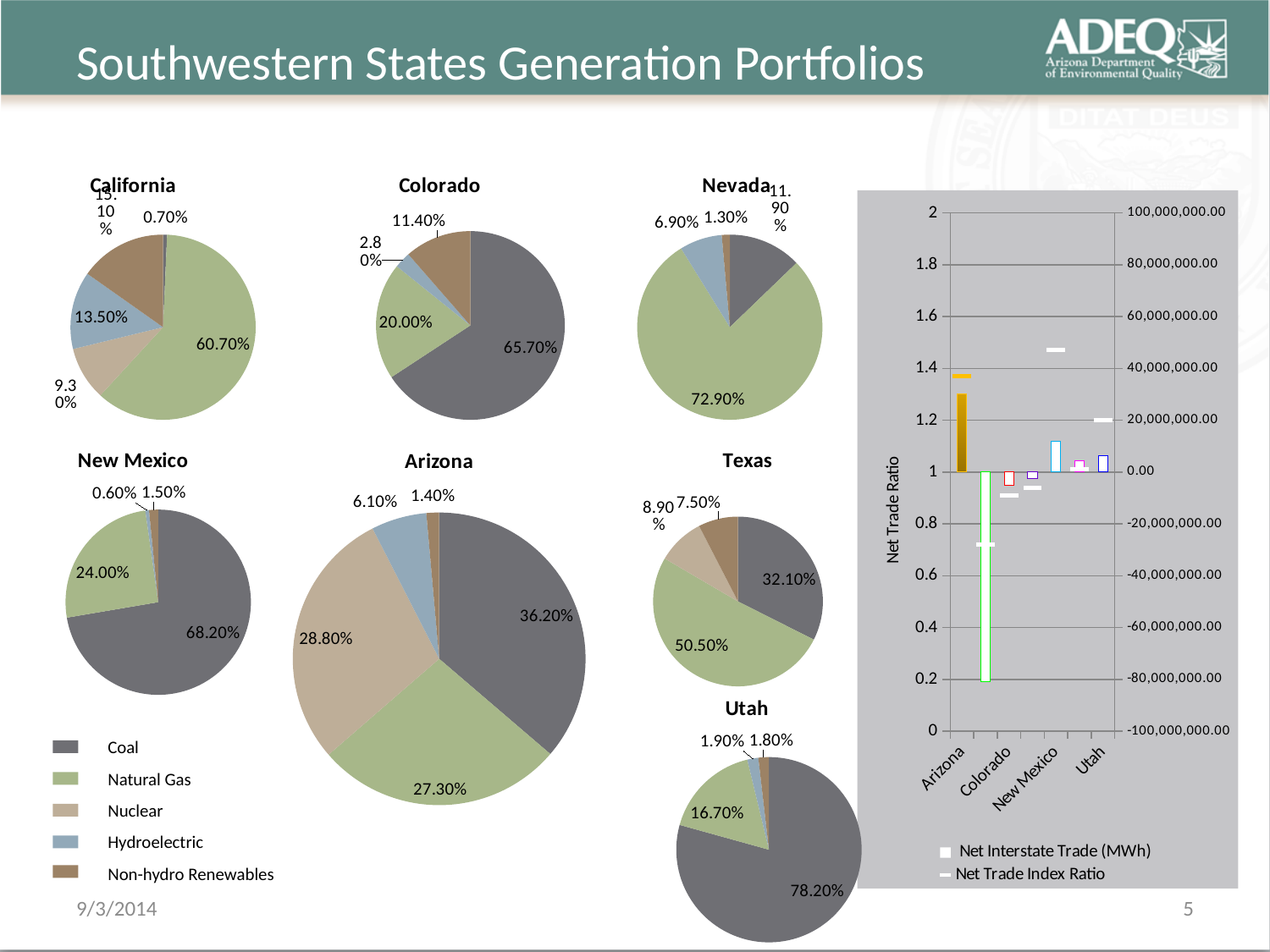
In the Colorado pie chart, what percentage is Coal? 65.70% In the New Mexico pie chart, which source has the smallest share? Hydroelectric In the Nevada pie chart, what is the Natural Gas share? 72.90% In the California pie chart, what share of generation comes from Natural Gas? 60.70% What kind of chart is the chart on the right of the slide showing Net Trade Ratio? Combination bar and line chart In the Arizona pie chart, what percentage is Nuclear? 28.80% How many slices does the Arizona pie chart have? 5 In the Texas pie chart, what is the difference between the Natural Gas share and the Coal share? 18.40% In the Arizona pie chart, which is larger, the Coal share or the Natural Gas share? Coal How many series does the legend of the Net Interstate Trade chart on the right list? 2 What is the y-axis label on the left side of the chart on the right of the slide? Net Trade Ratio In the Utah pie chart, which source has the largest share? Coal